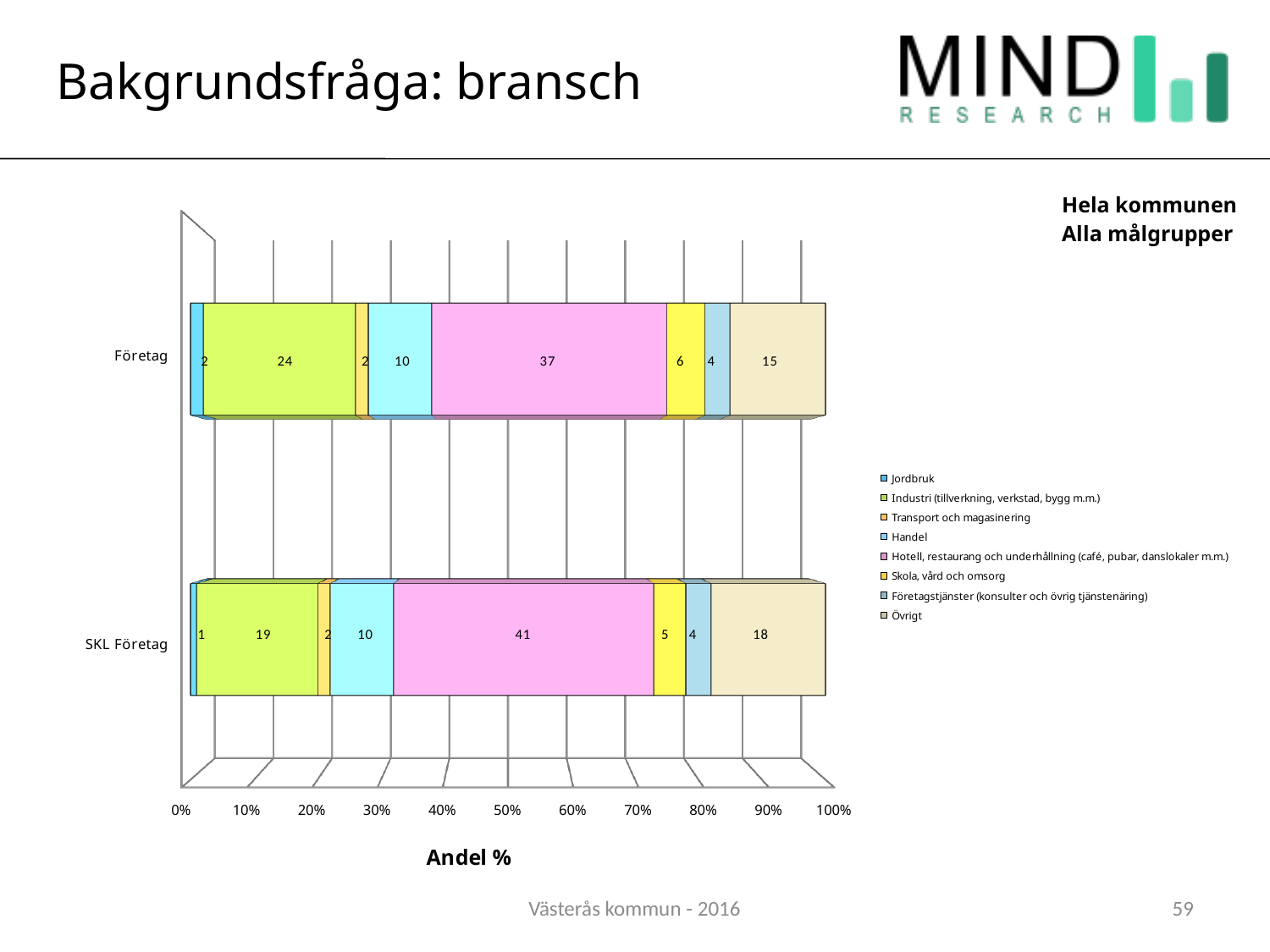
What kind of chart is shown on the slide? Stacked bar chart Which is larger: the Industri value for Företag or for SKL Företag? Företag What is the difference between the Hotell, restaurang och underhållning values for SKL Företag and Företag? 4 Which series has the largest segment in the Företag bar? Hotell, restaurang och underhållning (café, pubar, danslokaler m.m.) How many categories (bars) does the chart show? 2 What is the value for Hotell, restaurang och underhållning in the SKL Företag bar? 41 What is the value for Jordbruk in the SKL Företag bar? 1 What is the value for Övrigt in the Företag bar? 15 What is the total of the SKL Företag stacked bar? 100 How many series does the legend list? 8 What is the label of the x axis? Andel % What is the value for Industri (tillverkning, verkstad, bygg m.m.) in the Företag bar? 24